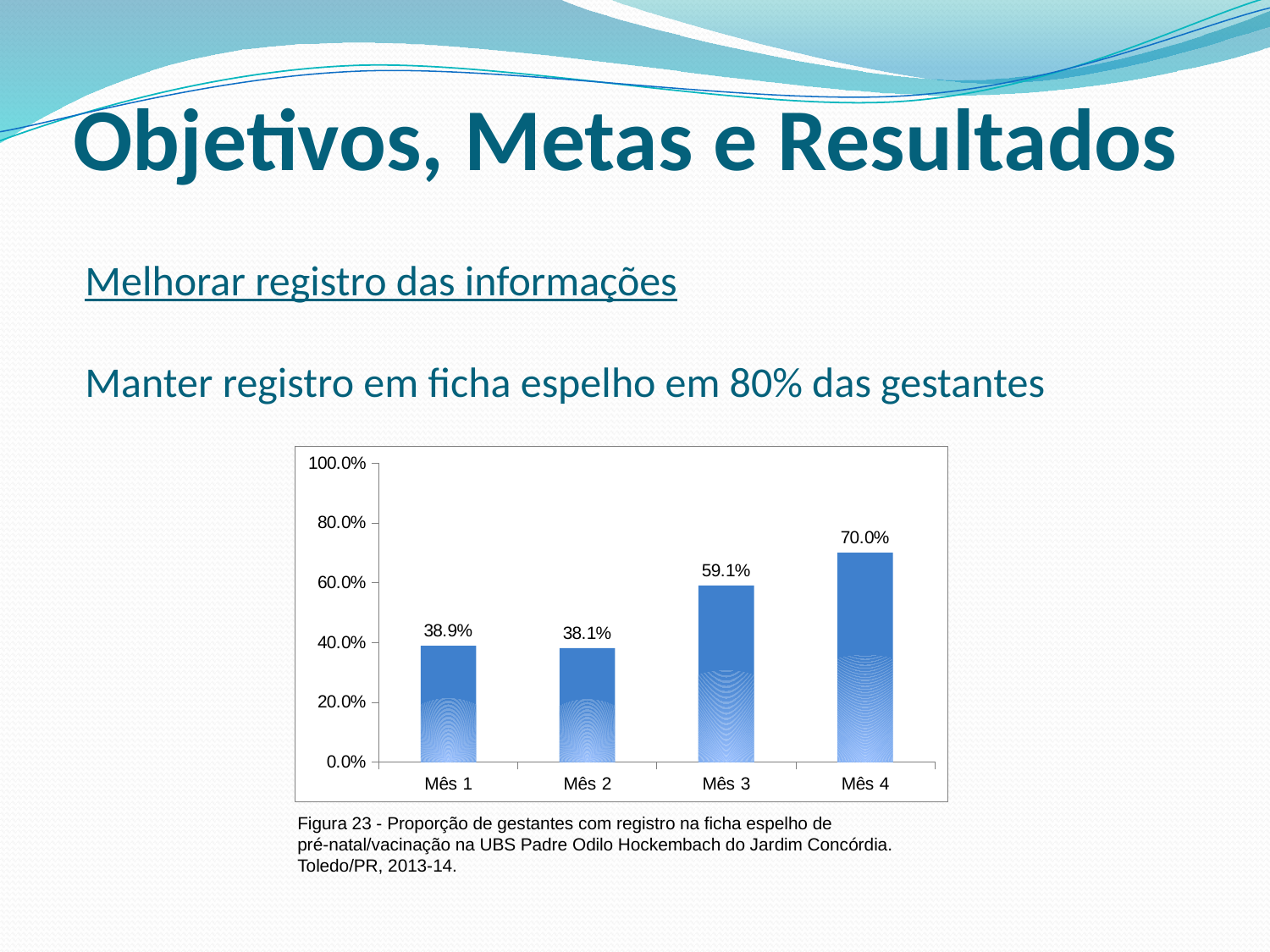
What kind of chart is shown on the slide? bar chart Is the value for Mês 4 greater or less than 80.0%? less How many months are shown on the x axis? 4 Do the values rise or fall from Mês 2 to Mês 4? rise What is the value for Mês 3? 59.1% What is the difference between the values for Mês 4 and Mês 3? 10.9% What is the value for Mês 1? 38.9% What is the value for Mês 4? 70.0% Which is larger, the value for Mês 3 or the value for Mês 1? Mês 3 Which month has the lowest value? Mês 2 Which month has the highest value? Mês 4 What is the difference between the values for Mês 1 and Mês 2? 0.8%